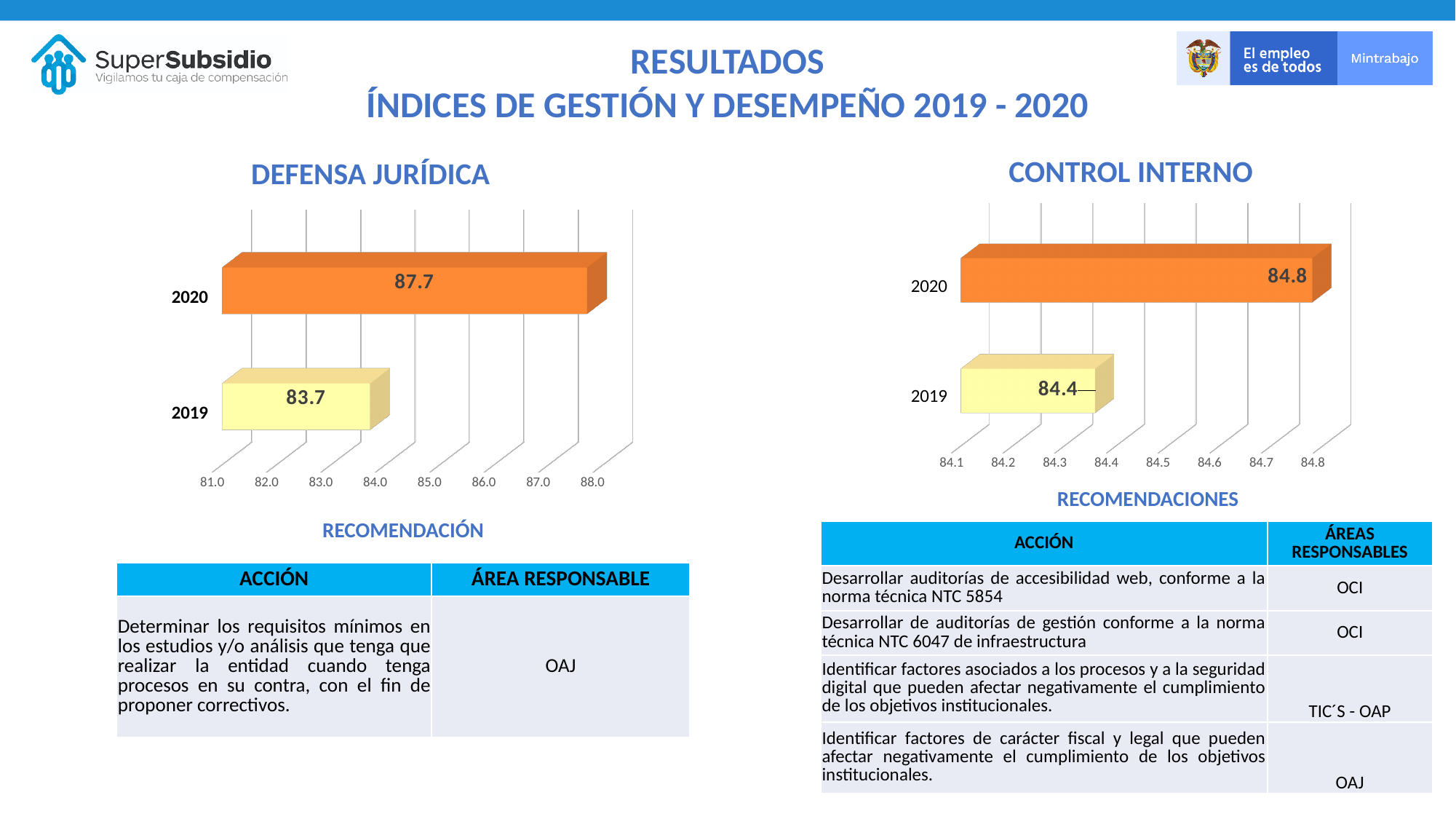
In the CONTROL INTERNO chart, what is the difference between the 2020 and 2019 values? 0.4 In the DEFENSA JURÍDICA chart, which year has the higher value? 2020 What kind of chart is the CONTROL INTERNO chart? bar chart In the CONTROL INTERNO chart, which year has the lower value? 2019 In the DEFENSA JURÍDICA chart, what is the value for 2020? 87.7 In the DEFENSA JURÍDICA chart, what is the value for 2019? 83.7 In the CONTROL INTERNO chart, what is the value for 2020? 84.8 In the CONTROL INTERNO chart, is the value for 2020 larger or smaller than the value for 2019? larger How many bars does the DEFENSA JURÍDICA chart show? 2 In the CONTROL INTERNO chart, what is the value for 2019? 84.4 In the DEFENSA JURÍDICA chart, do the values rise or fall from 2019 to 2020? rise In the DEFENSA JURÍDICA chart, what is the difference between the 2020 and 2019 values? 4.0